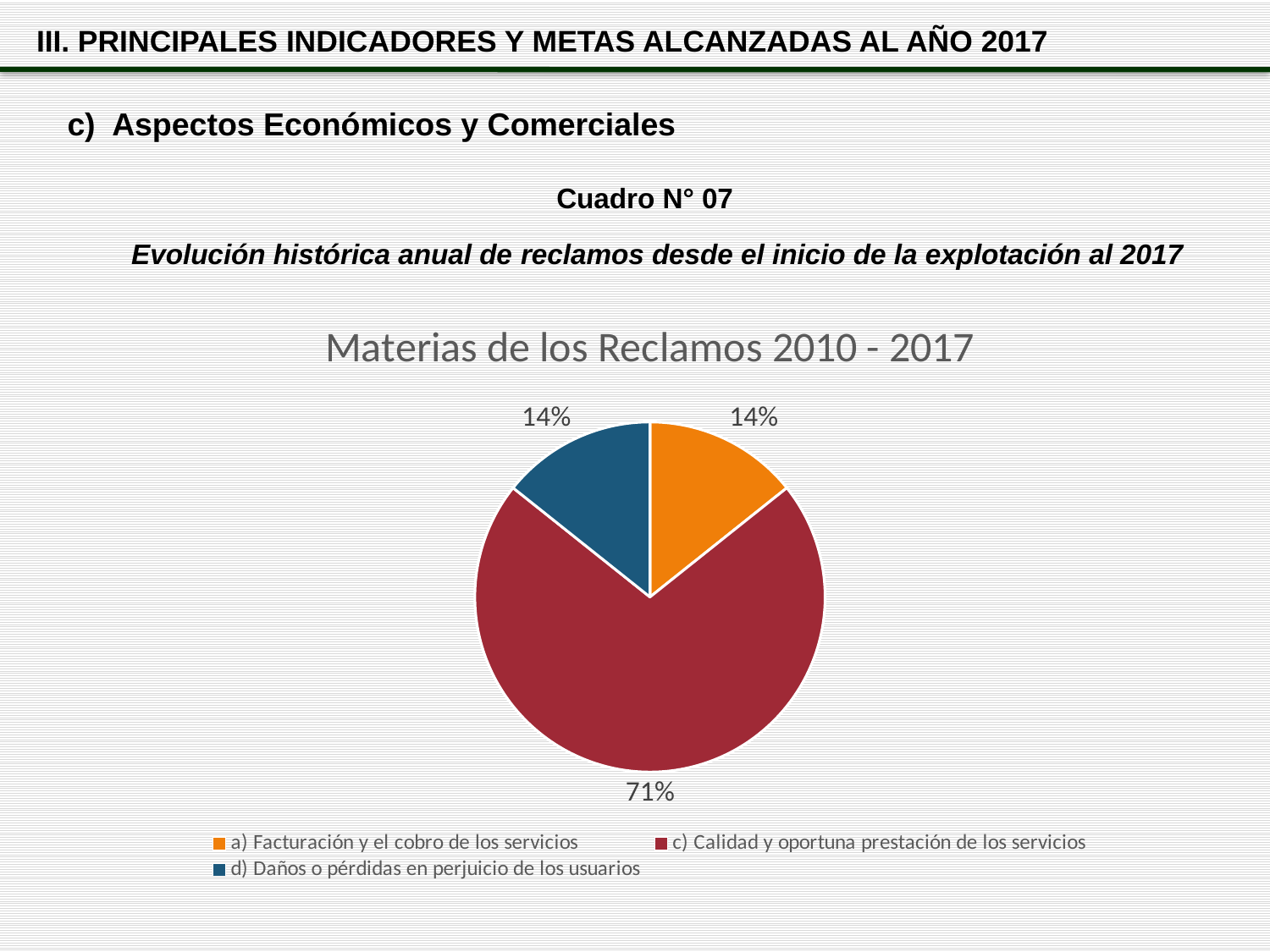
What share of the pie does "d) Daños o pérdidas en perjuicio de los usuarios" represent? 14% How many slices does the pie chart have? 3 What is the title of the chart? Materias de los Reclamos 2010 - 2017 How many entries does the legend list? 3 What share of the pie does "a) Facturación y el cobro de los servicios" represent? 14% What kind of chart is shown on the slide? pie chart What share of the pie does "c) Calidad y oportuna prestación de los servicios" represent? 71% What is the difference in percentage points between the slice for "c) Calidad y oportuna prestación de los servicios" and the slice for "a) Facturación y el cobro de los servicios"? 57 Which is larger: the slice for "c) Calidad y oportuna prestación de los servicios" or the slice for "d) Daños o pérdidas en perjuicio de los usuarios"? c) Calidad y oportuna prestación de los servicios Which category has the largest slice of the pie? c) Calidad y oportuna prestación de los servicios Which colour is used for the slice "c) Calidad y oportuna prestación de los servicios"? dark red